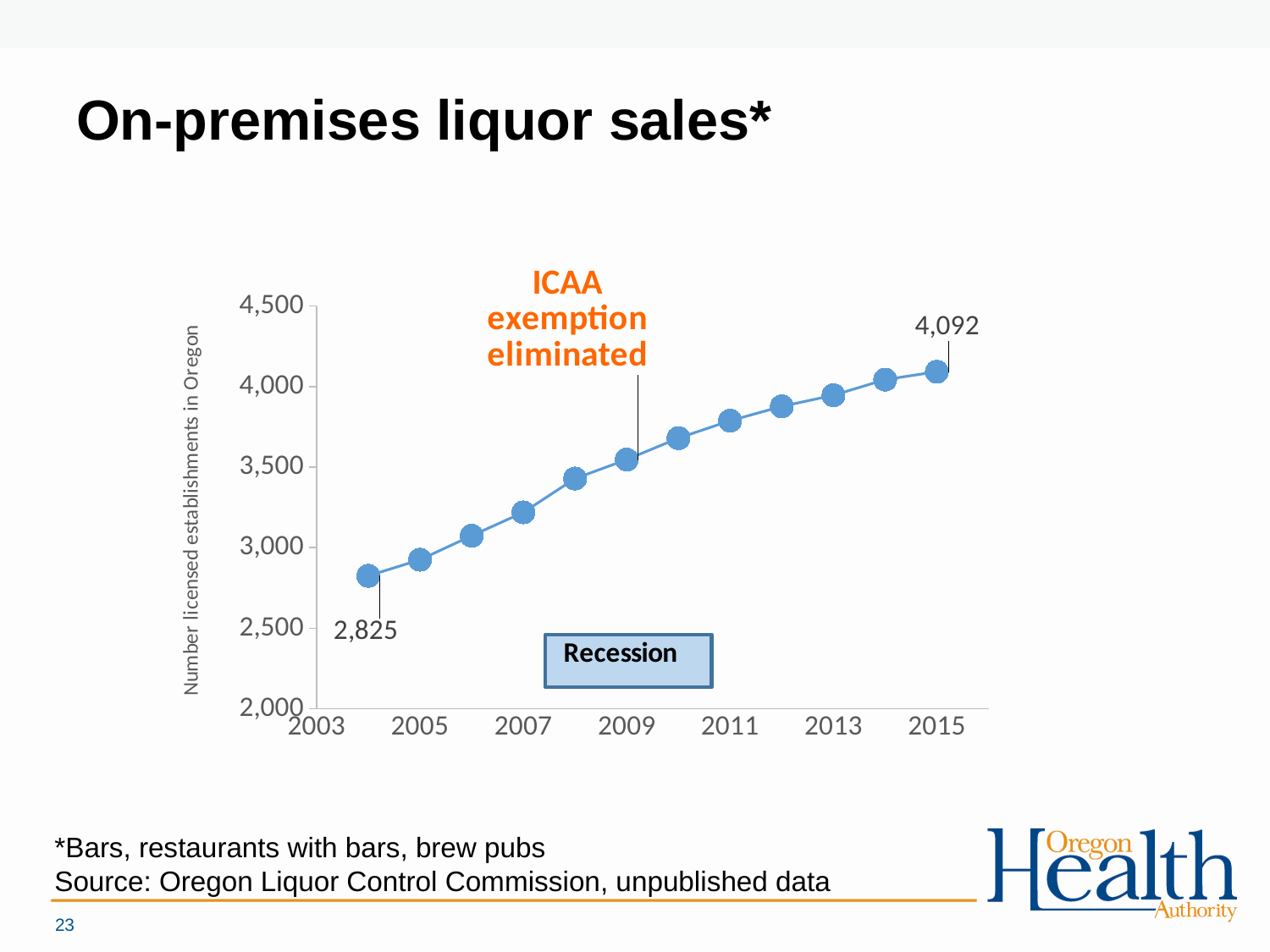
Is the value for 2012 greater or less than 4,000? less What kind of chart is shown on the slide? line chart What is the label on the vertical axis of the chart? Number licensed establishments in Oregon By how much did the number of licensed establishments increase from 2004 to 2015? 1,267 Which year has a larger value, 2006 or 2010? 2010 Which year has the highest number of licensed establishments? 2015 What is the number of licensed establishments in Oregon shown for 2015? 4,092 Which year has the lowest number of licensed establishments? 2004 Do the values rise or fall from 2004 to 2015? rise How many data points are plotted on the chart? 12 Is the value for 2008 greater or less than 3,500? less What is the number of licensed establishments in Oregon shown for 2004? 2,825